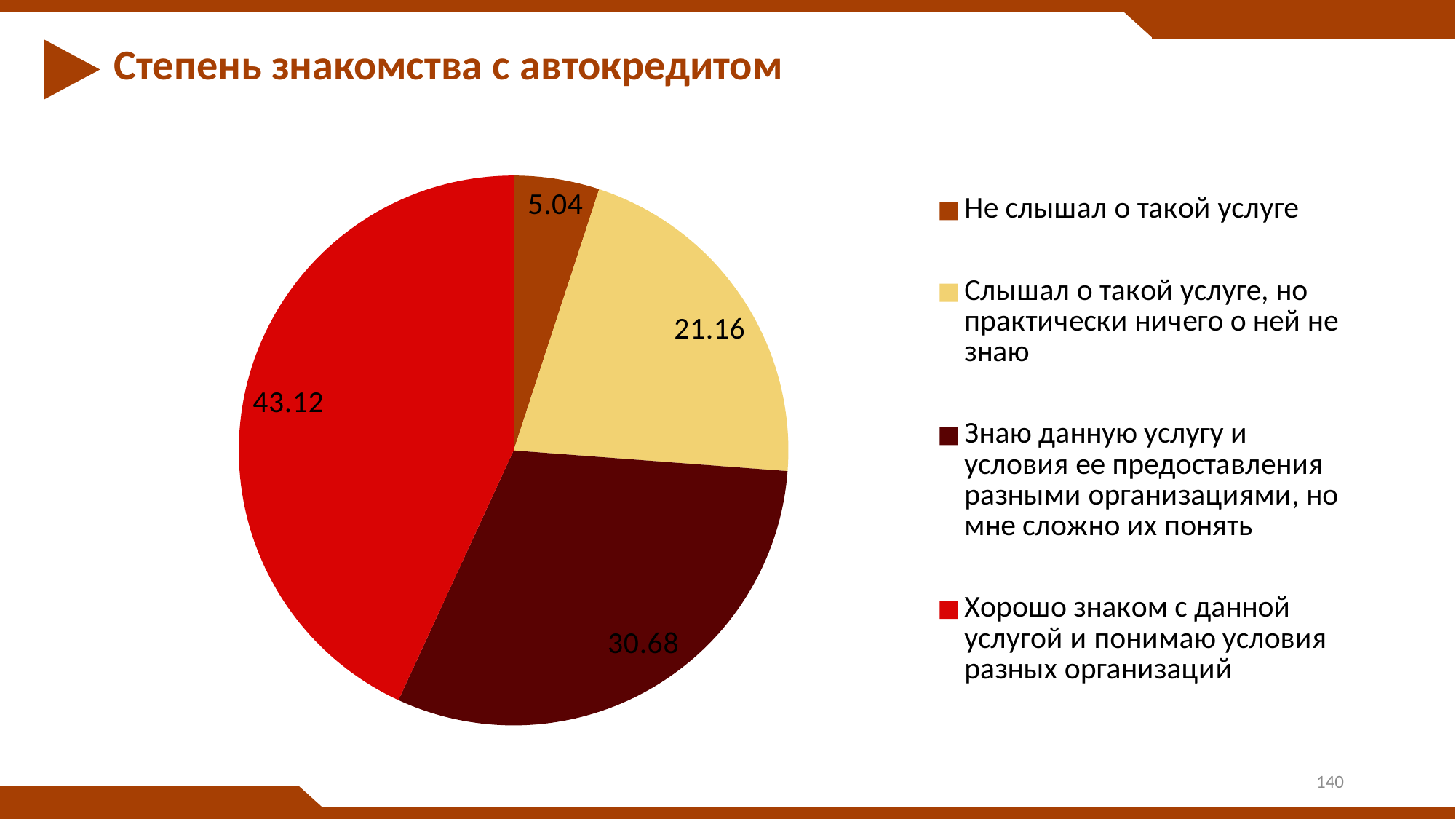
Which is larger: the value for "Слышал о такой услуге, но практически ничего о ней не знаю" or the value for "Не слышал о такой услуге"? Слышал о такой услуге, но практически ничего о ней не знаю What is the value for "Не слышал о такой услуге"? 5.04 What type of chart is shown on the slide? pie chart Which category has the smallest slice of the pie? Не слышал о такой услуге How many slices does the pie chart have? 4 Which category has the largest slice of the pie? Хорошо знаком с данной услугой и понимаю условия разных организаций What is the value for "Слышал о такой услуге, но практически ничего о ней не знаю"? 21.16 What is the title of the chart? Степень знакомства с автокредитом How many entries does the legend list? 4 What is the value for "Знаю данную услугу и условия ее предоставления разными организациями, но мне сложно их понять"? 30.68 What is the difference between the values for "Хорошо знаком с данной услугой и понимаю условия разных организаций" and "Знаю данную услугу и условия ее предоставления разными организациями, но мне сложно их понять"? 12.44 What colour is the slice for "Хорошо знаком с данной услугой и понимаю условия разных организаций"? red